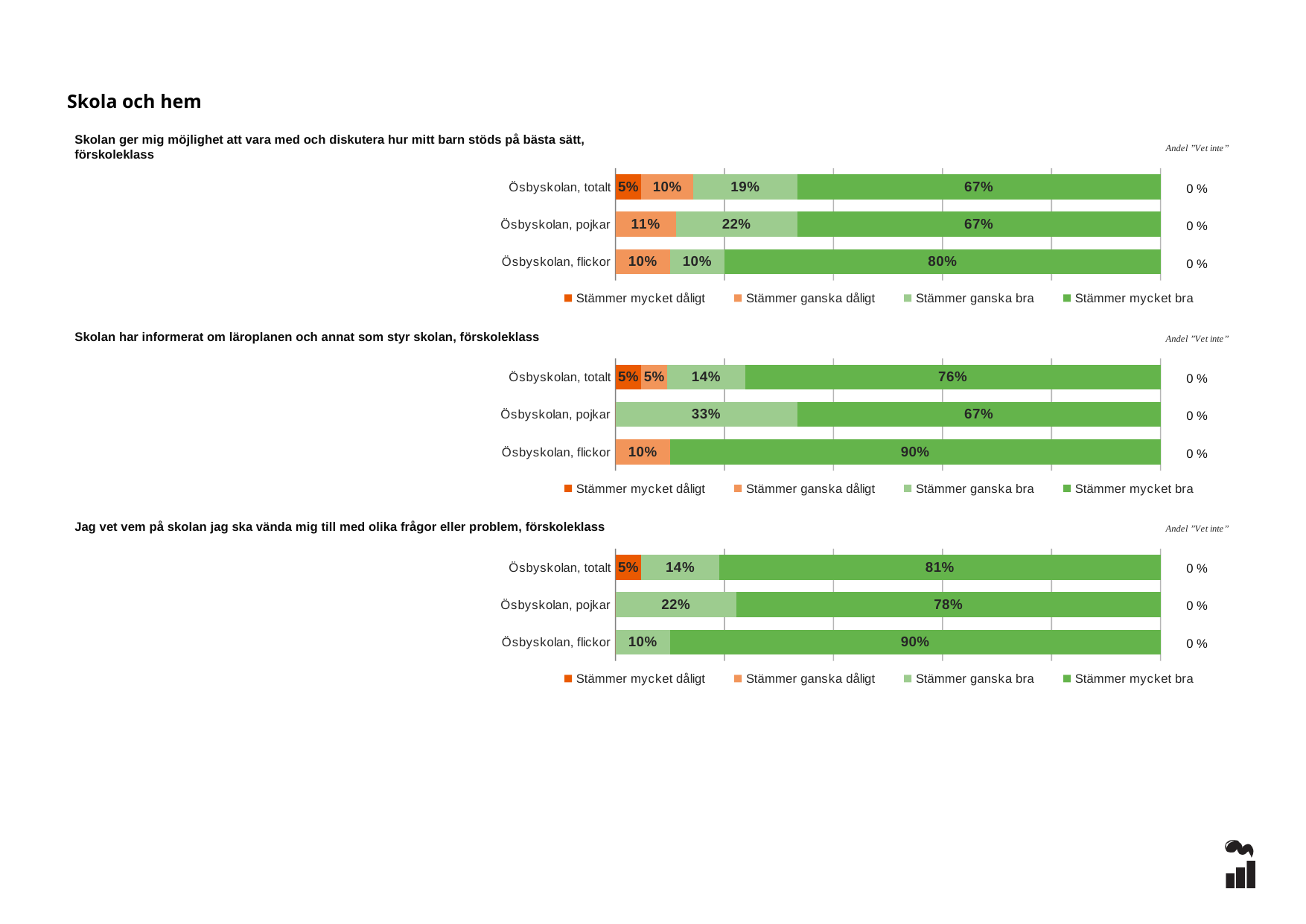
In the top chart (Skolan ger mig möjlighet att vara med och diskutera...), what is the value of 'Stämmer mycket bra' for Ösbyskolan, flickor? 80% In the top chart (Skolan ger mig möjlighet att vara med och diskutera...), which category has the highest 'Stämmer mycket bra' value? Ösbyskolan, flickor In the bottom chart (Jag vet vem på skolan jag ska vända mig till...), what is the difference between the 'Stämmer ganska bra' values for Ösbyskolan, pojkar and Ösbyskolan, totalt? 8% In the middle chart (Skolan har informerat om läroplanen...), what is the difference between the 'Stämmer mycket bra' values for Ösbyskolan, flickor and Ösbyskolan, totalt? 14% In the bottom chart (Jag vet vem på skolan jag ska vända mig till...), is the 'Stämmer mycket bra' value for Ösbyskolan, pojkar or Ösbyskolan, flickor larger? Ösbyskolan, flickor In the bottom chart (Jag vet vem på skolan jag ska vända mig till...), what is the value of 'Stämmer mycket bra' for Ösbyskolan, totalt? 81% In the top chart (Skolan ger mig möjlighet att vara med och diskutera...), what is the value of 'Stämmer ganska bra' for Ösbyskolan, pojkar? 22% What kind of chart is the bottom chart (Jag vet vem på skolan jag ska vända mig till...)? Stacked bar chart In the middle chart (Skolan har informerat om läroplanen...), what is the value of 'Stämmer ganska bra' for Ösbyskolan, pojkar? 33% How many series does the legend of the top chart list? 4 How many categories are shown in the middle chart (Skolan har informerat om läroplanen...)? 3 In the middle chart (Skolan har informerat om läroplanen...), which category has the lowest 'Stämmer mycket bra' value? Ösbyskolan, pojkar